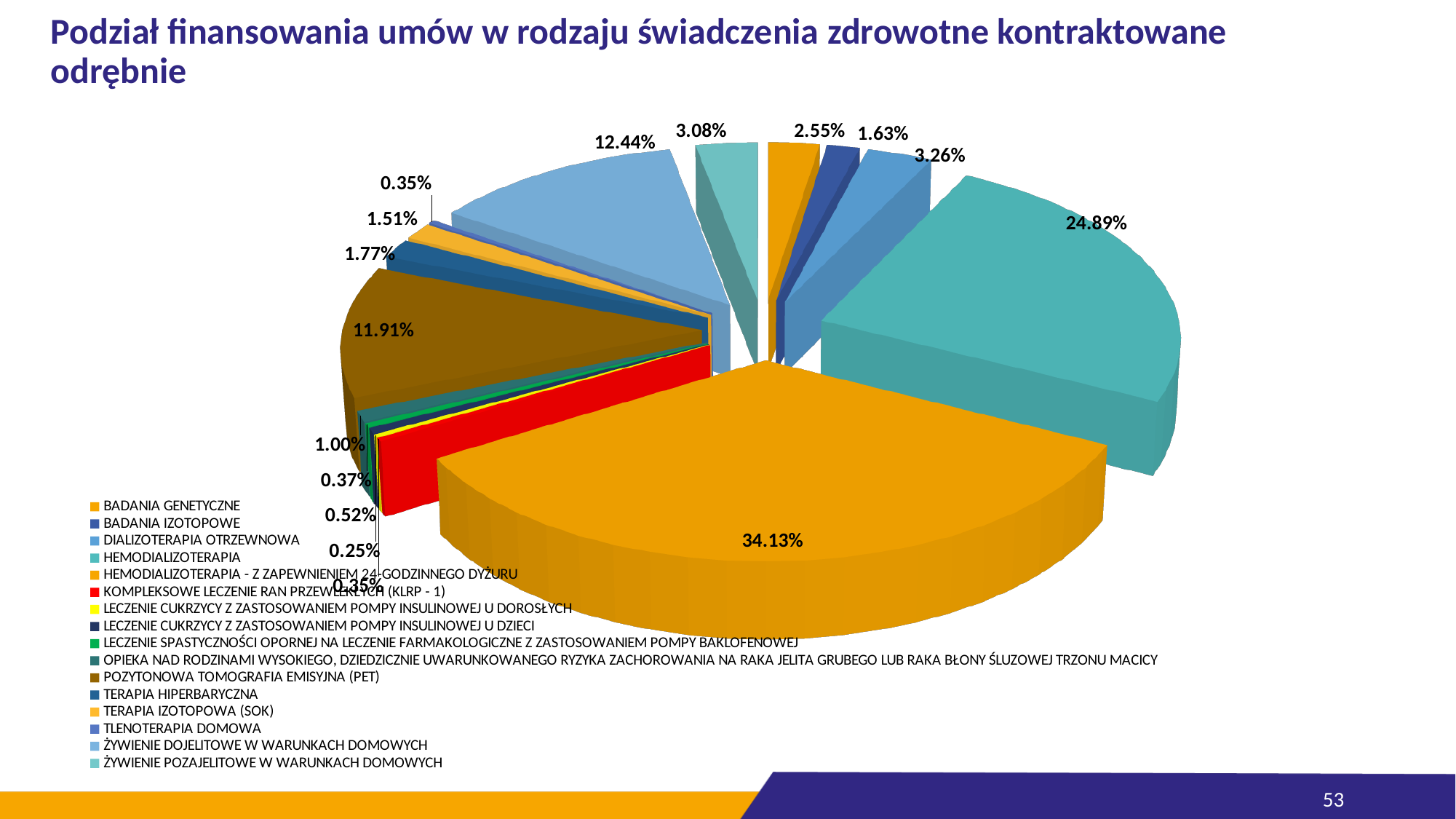
Which has the larger share: ŻYWIENIE DOJELITOWE W WARUNKACH DOMOWYCH or POZYTONOWA TOMOGRAFIA EMISYJNA (PET)? ŻYWIENIE DOJELITOWE W WARUNKACH DOMOWYCH What share of the pie does POZYTONOWA TOMOGRAFIA EMISYJNA (PET) have? 11.91% What is the smallest percentage label shown on the pie chart? 0.25% What is the title of the chart on the slide? Podział finansowania umów w rodzaju świadczenia zdrowotne kontraktowane odrębnie What is the difference in percentage points between the share of HEMODIALIZOTERAPIA - Z ZAPEWNIENIEM 24-GODZINNEGO DYŻURU and HEMODIALIZOTERAPIA? 9.24 What share of the pie does DIALIZOTERAPIA OTRZEWNOWA have? 3.26% What share of the pie does HEMODIALIZOTERAPIA have? 24.89% Which category has the largest share of the pie? HEMODIALIZOTERAPIA - Z ZAPEWNIENIEM 24-GODZINNEGO DYŻURU What is the largest share shown on the pie chart? 34.13% How many categories does the legend of the pie chart list? 16 What kind of chart is shown on the slide? pie chart